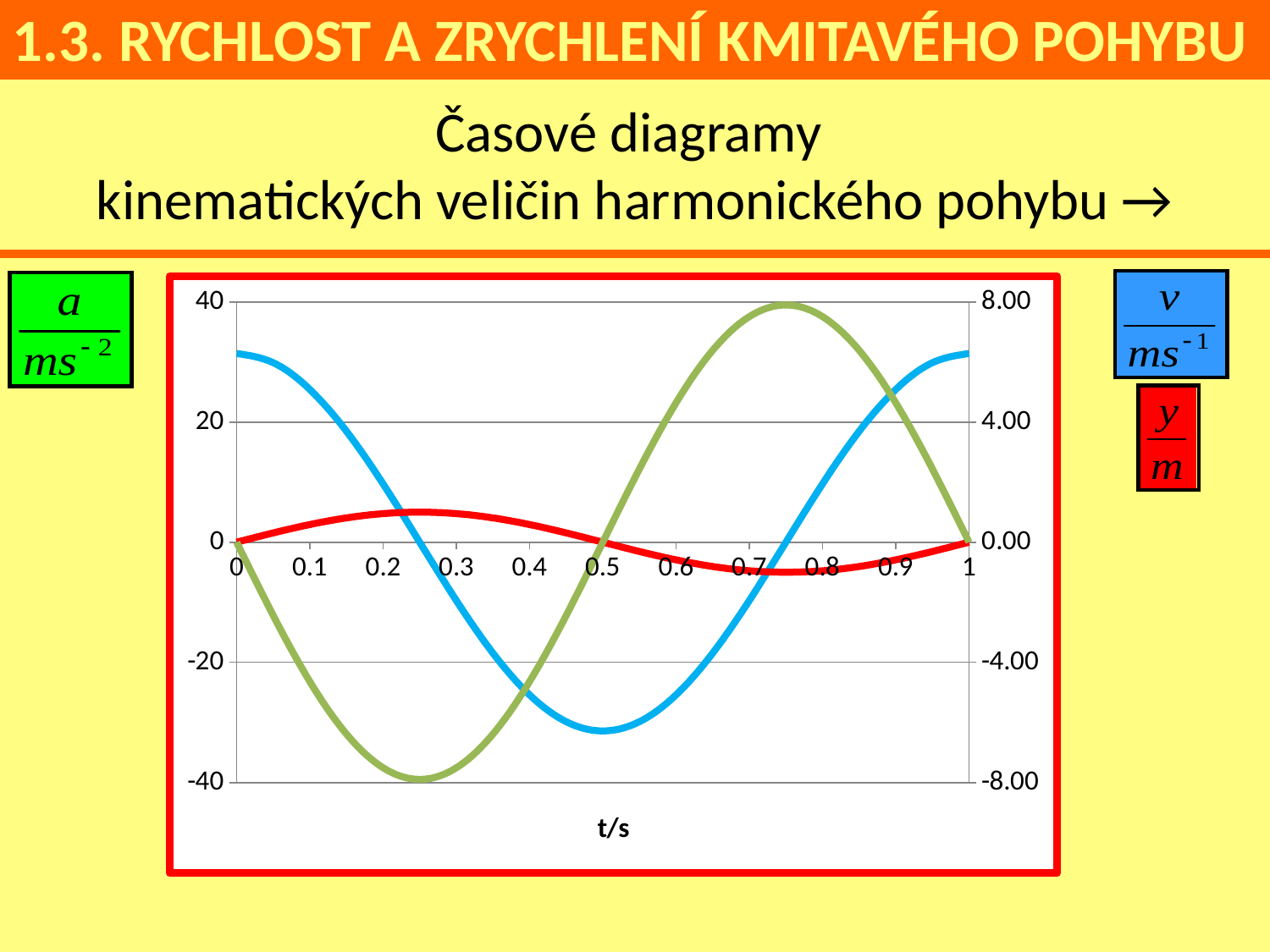
What is the value of the red curve (y) at t = 0.5? 0.00 What is the value of the green curve (a) at t = 1? 0 Is the value of the blue curve (v) at t = 0.5 greater or less than -4.00 on the right axis? less At t = 0, which curve has the higher value, the blue curve (v) or the red curve (y)? blue curve (v) What kind of chart is shown on the slide? line chart What is the label of the horizontal axis of the chart? t/s Is the value of the blue curve (v) at t = 0 greater or less than 4.00 on the right axis? greater Is the value of the green curve (a) at t = 0.25 greater or less than -20 on the left axis? less What is the value of the green curve (a) at t = 0? 0 What is the highest tick value shown on the right-hand vertical axis? 8.00 Does the green curve (a) rise or fall between t = 0 and t = 0.25? fall How many curves are plotted on the chart? 3